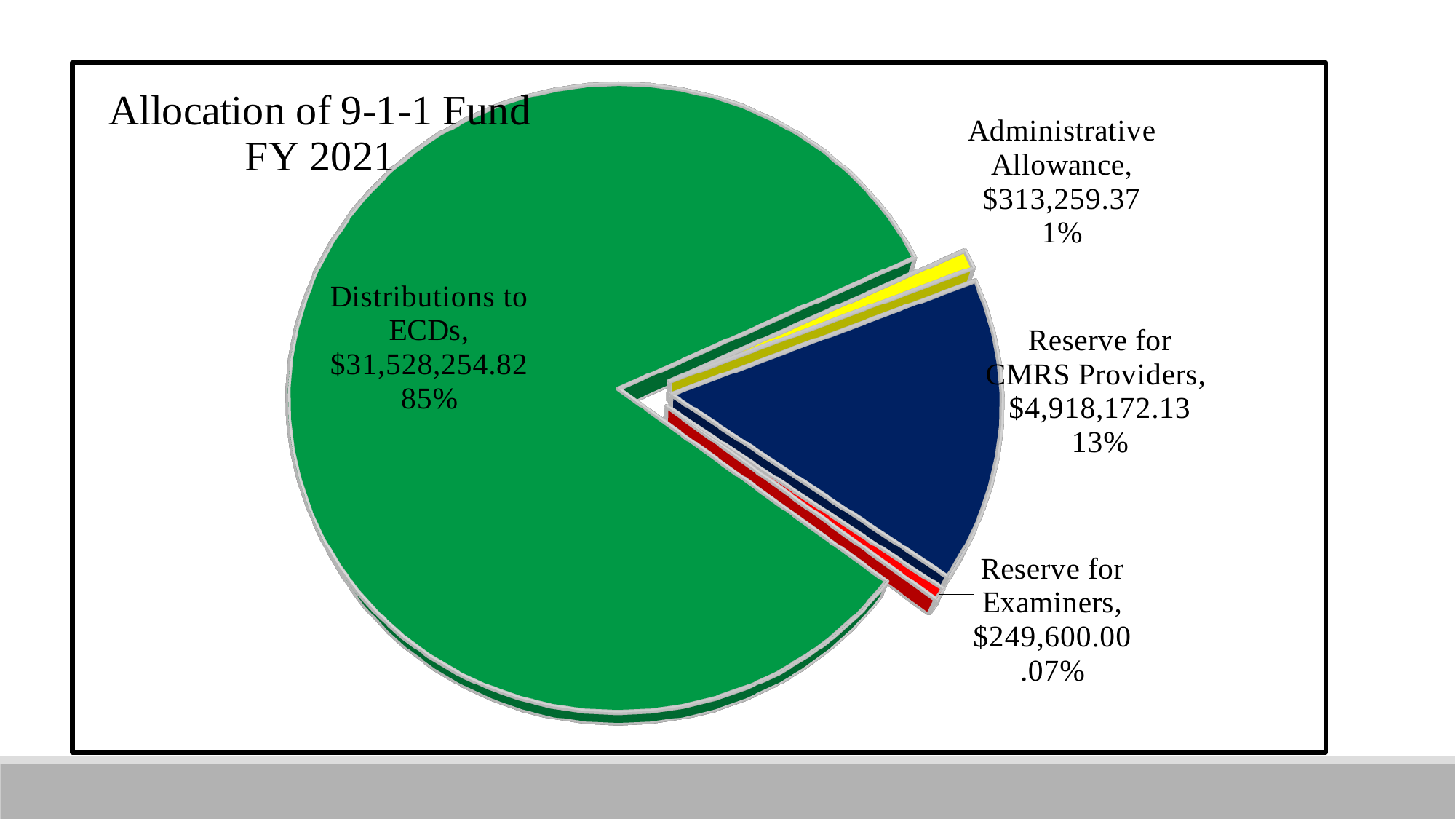
What is the dollar value for Reserve for Examiners? $249,600.00 Which category receives the smallest allocation? Reserve for Examiners What is the dollar value for Distributions to ECDs? $31,528,254.82 What is the title of the chart? Allocation of 9-1-1 Fund FY 2021 What is the difference between the Reserve for CMRS Providers and the Administrative Allowance? $4,604,912.76 What is the dollar value for Reserve for CMRS Providers? $4,918,172.13 What kind of chart is shown on the slide? Pie chart Which category receives the largest allocation? Distributions to ECDs What share of the fund goes to Reserve for CMRS Providers? 13% What share of the fund goes to Distributions to ECDs? 85% How many slices does the pie chart have? 4 What is the dollar value for Administrative Allowance? $313,259.37